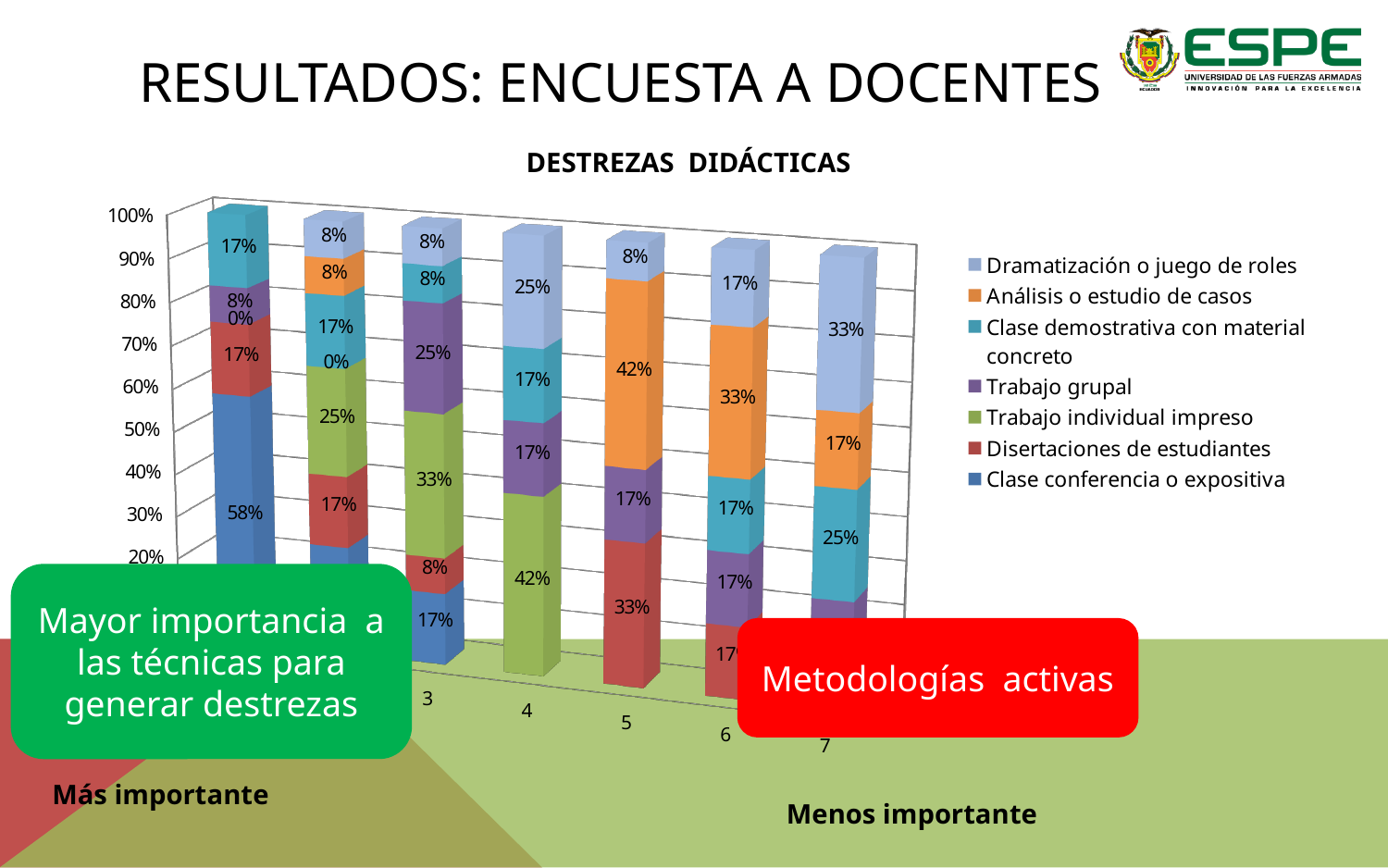
How many series does the legend of the chart list? 7 What kind of chart is shown on the slide? Stacked bar chart What is the value of Dramatización o juego de roles for category 7? 33% What is the value of Trabajo individual impreso for category 4? 42% What is the difference between the Dramatización o juego de roles values for category 7 and category 4? 8 percentage points What is the chart's title? DESTREZAS DIDÁCTICAS What is the value of Trabajo grupal for category 3? 25% Which series is listed first in the chart's legend? Dramatización o juego de roles What is the value of Disertaciones de estudiantes for category 5? 33% What is the value of Análisis o estudio de casos for category 5? 42% Which has a larger value for Análisis o estudio de casos, category 5 or category 7? Category 5 What is the value of Clase demostrativa con material concreto for category 7? 25%